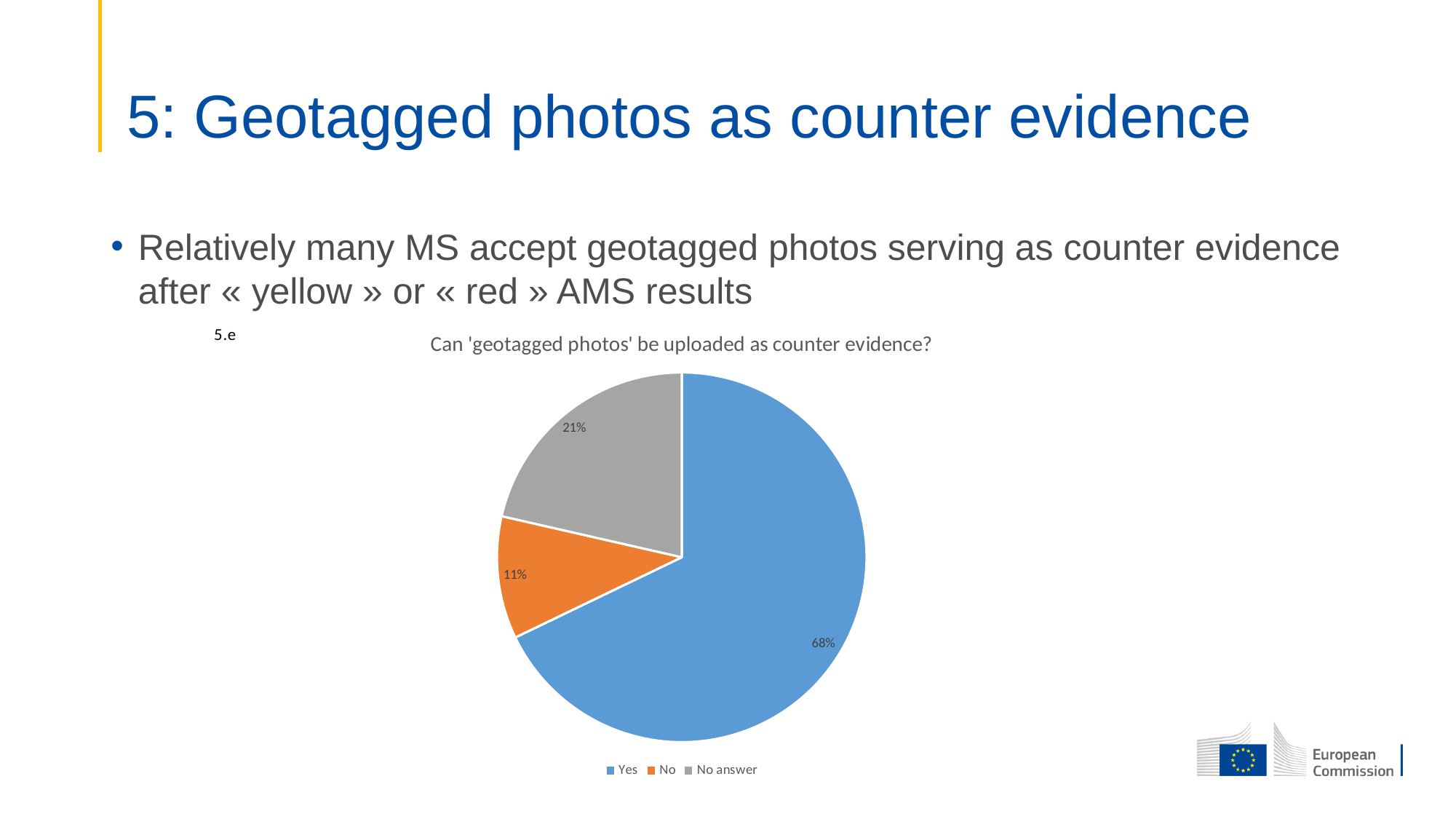
How many slices does the pie chart have? 3 What percentage of the pie is labelled 'Yes'? 68% How many entries does the legend list? 3 Which category has the smallest share of the pie? No What is the title of the chart? Can 'geotagged photos' be uploaded as counter evidence? What is the difference in percentage points between the 'Yes' and 'No answer' slices? 47 What type of chart is shown on the slide? Pie chart What percentage of the pie is labelled 'No'? 11% What percentage of the pie is labelled 'No answer'? 21% Which category has the largest share of the pie? Yes Which slice is larger, 'No' or 'No answer'? No answer What colour is the 'Yes' slice? Blue